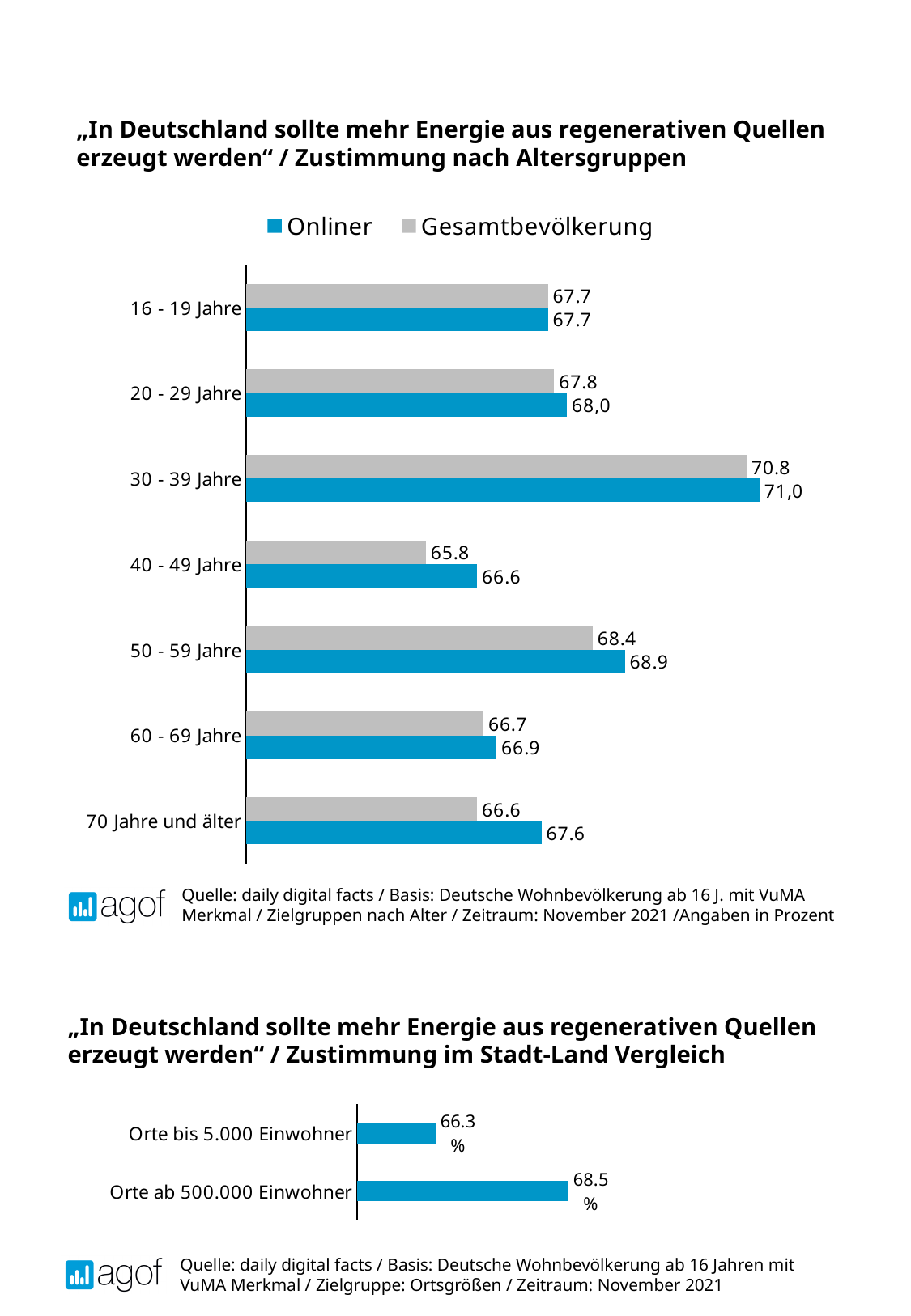
In the bottom chart (Zustimmung im Stadt-Land Vergleich), what is the value for Orte ab 500.000 Einwohner? 68.5 % In the top chart (Zustimmung nach Altersgruppen), what is the difference between the Onliner and Gesamtbevölkerung values for 70 Jahre und älter? 1.0 How many age groups are shown in the top chart (Zustimmung nach Altersgruppen)? 7 In the top chart (Zustimmung nach Altersgruppen), which age group has the highest Gesamtbevölkerung value? 30 - 39 Jahre In the top chart (Zustimmung nach Altersgruppen), what is the Onliner value for 30 - 39 Jahre? 71,0 In the bottom chart (Zustimmung im Stadt-Land Vergleich), which category has the lower value? Orte bis 5.000 Einwohner In the top chart (Zustimmung nach Altersgruppen), what is the Gesamtbevölkerung value for 40 - 49 Jahre? 65.8 In the top chart (Zustimmung nach Altersgruppen), which is larger for 50 - 59 Jahre: the Onliner value or the Gesamtbevölkerung value? Onliner In the top chart (Zustimmung nach Altersgruppen), which colour represents the Onliner series? Blue In the top chart (Zustimmung nach Altersgruppen), which age group has the lowest Onliner value? 40 - 49 Jahre What kind of chart is the top chart (Zustimmung nach Altersgruppen)? Bar chart How many series does the legend of the top chart (Zustimmung nach Altersgruppen) list? 2